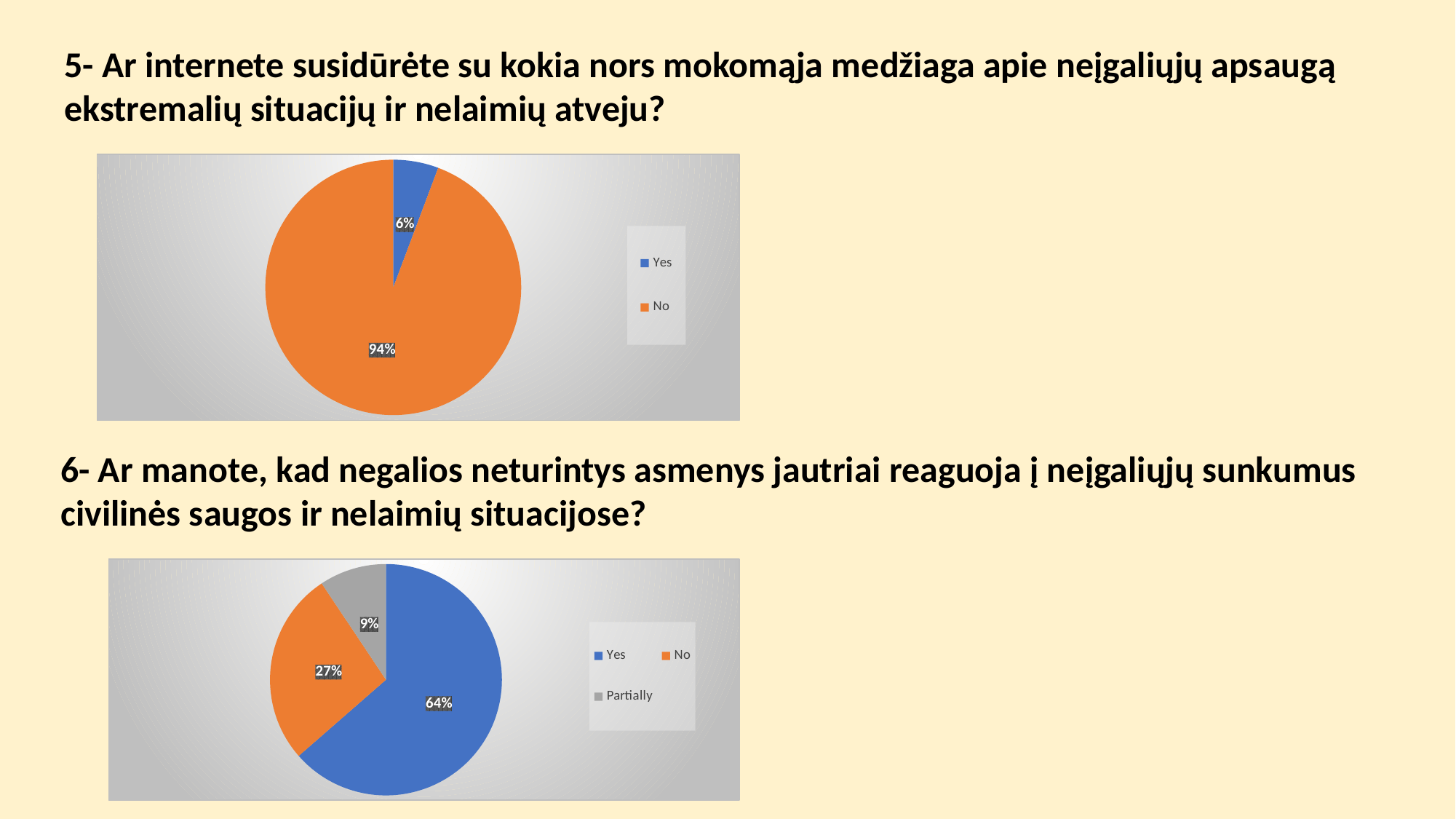
In the top pie chart (question 5), what share of respondents answered Yes? 6% In the bottom pie chart (question 6), what colour is the Partially slice? Grey In the bottom pie chart (question 6), how many slices does the pie have? 3 In the top pie chart (question 5), which answer has the largest share? No In the bottom pie chart (question 6), what share of respondents answered Partially? 9% In the bottom pie chart (question 6), what share of respondents answered Yes? 64% In the top pie chart (question 5), how many entries does the legend list? 2 In the top pie chart (question 5), what share of respondents answered No? 94% In the top pie chart (question 5), what is the difference in percentage points between the No and Yes shares? 88 In the bottom pie chart (question 6), which is larger, the share for No or the share for Partially? No What type of chart is shown under question 5? Pie chart In the bottom pie chart (question 6), which answer has the smallest share? Partially